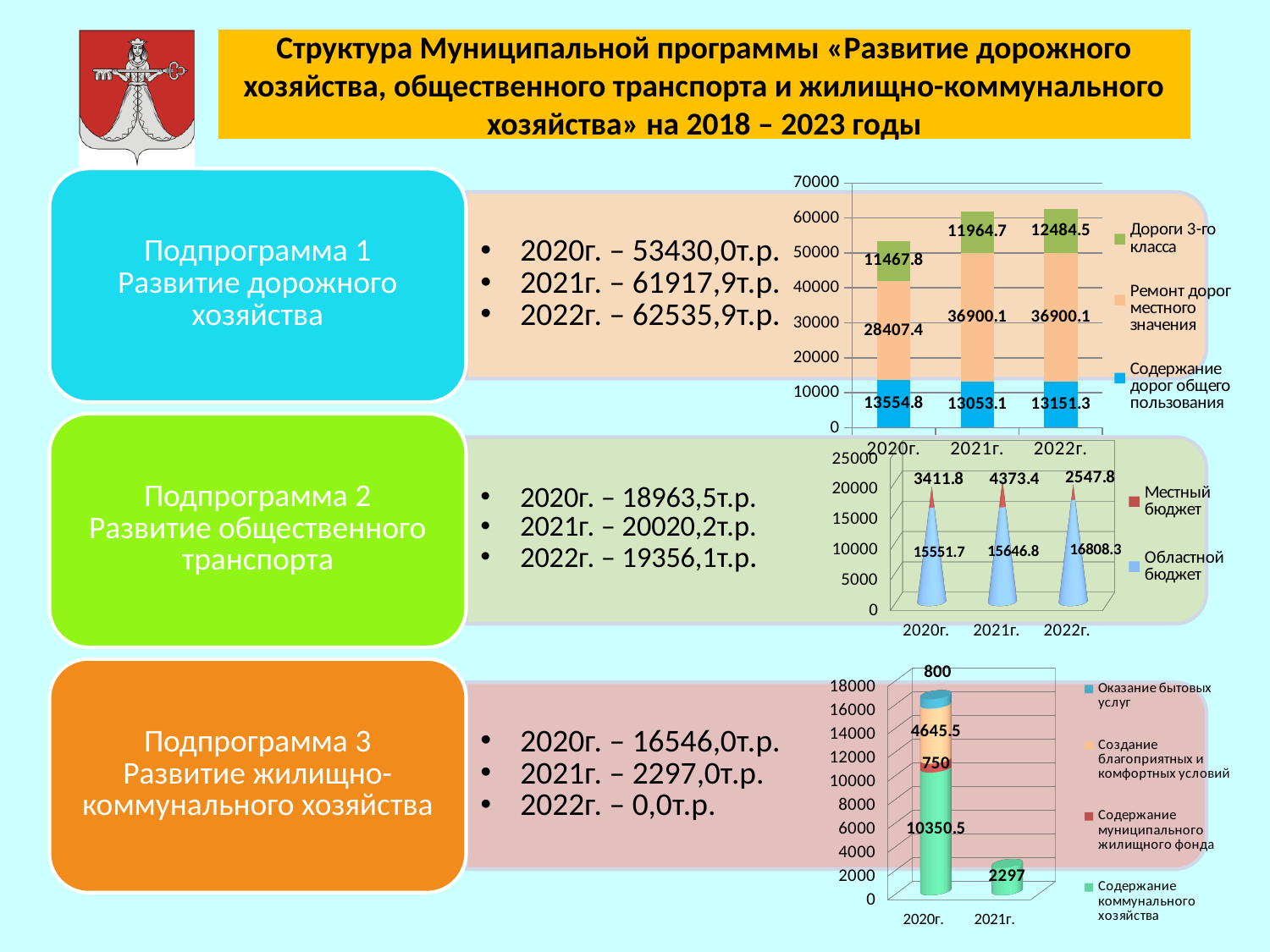
In the middle chart, which year has the lowest value for Местный бюджет? 2022г. In the top chart, what is the difference between the Ремонт дорог местного значения values for 2021г. and 2020г.? 8492.7 In the top chart, how many series does the legend list? 3 In the bottom chart, how many series does the legend list? 4 In the bottom chart, what is the value for Содержание коммунального хозяйства in 2020г.? 10350.5 In the middle chart, what is the total of Местный бюджет and Областной бюджет for 2021г.? 20020.2 In the bottom chart, what is the value shown for 2021г.? 2297 In the middle chart, how many years are shown on the x axis? 3 In the top chart, which year has the highest value for Содержание дорог общего пользования? 2020г. In the top chart, what is the value for Дороги 3-го класса in 2022г.? 12484.5 In the middle chart, what is the value for Областной бюджет in 2022г.? 16808.3 In the top chart, what is the value for Ремонт дорог местного значения in 2020г.? 28407.4